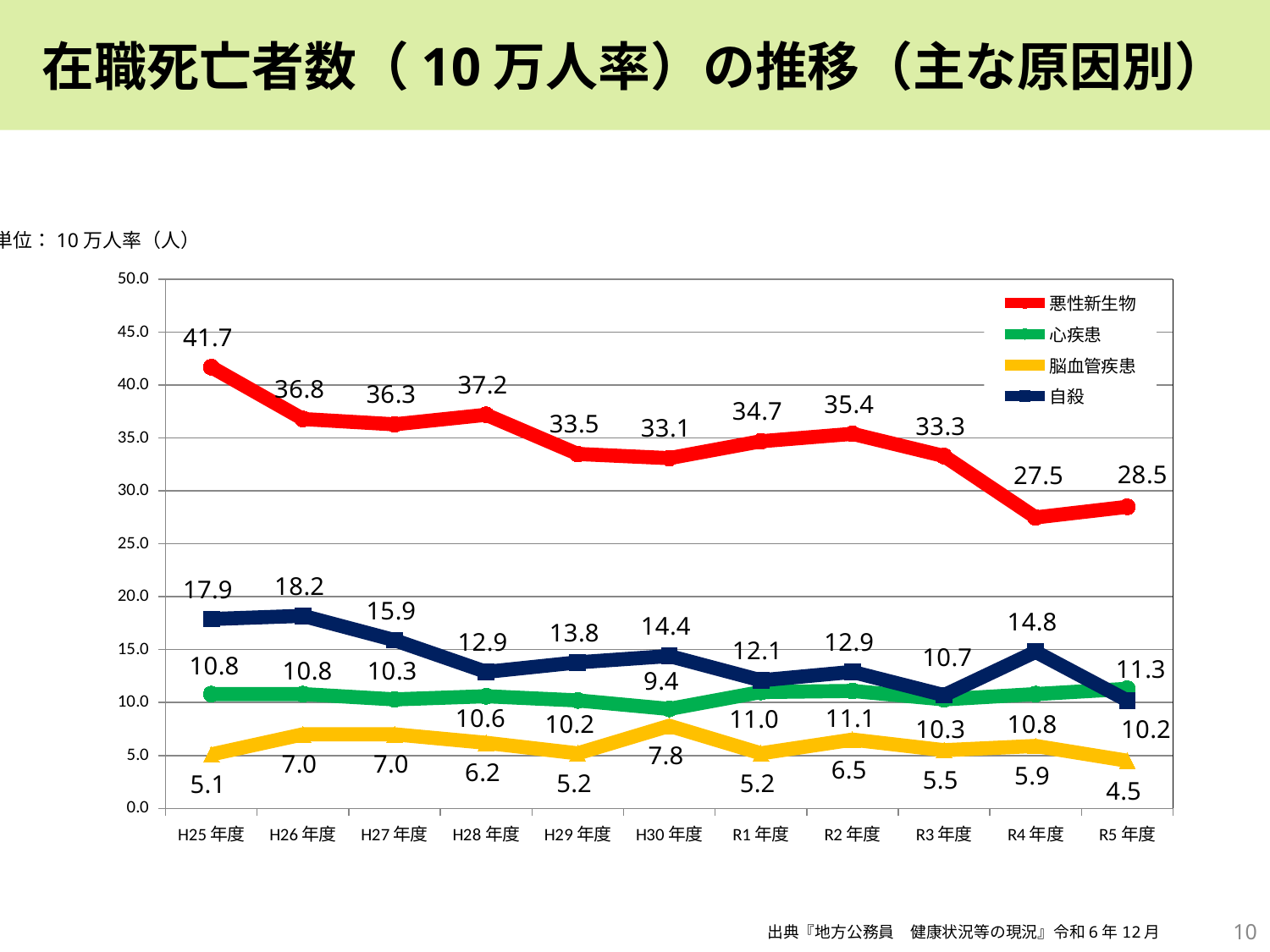
What is the value for 悪性新生物 in H25年度? 41.7 Which series is drawn in red? 悪性新生物 In which fiscal year is the value for 悪性新生物 the lowest? R4年度 What is the value for 脳血管疾患 in H30年度? 7.8 What is the difference between the 悪性新生物 values in H25年度 and H26年度? 4.9 What is the value for 自殺 in R4年度? 14.8 How many series does the legend list? 4 How many fiscal years are plotted along the x axis? 11 What type of chart is shown on the slide? line chart In which fiscal year is the value for 脳血管疾患 the highest? H30年度 Which is larger in H28年度, the value for 自殺 or the value for 心疾患? 自殺 Is the value for 悪性新生物 in R5年度 greater or less than 30.0? less